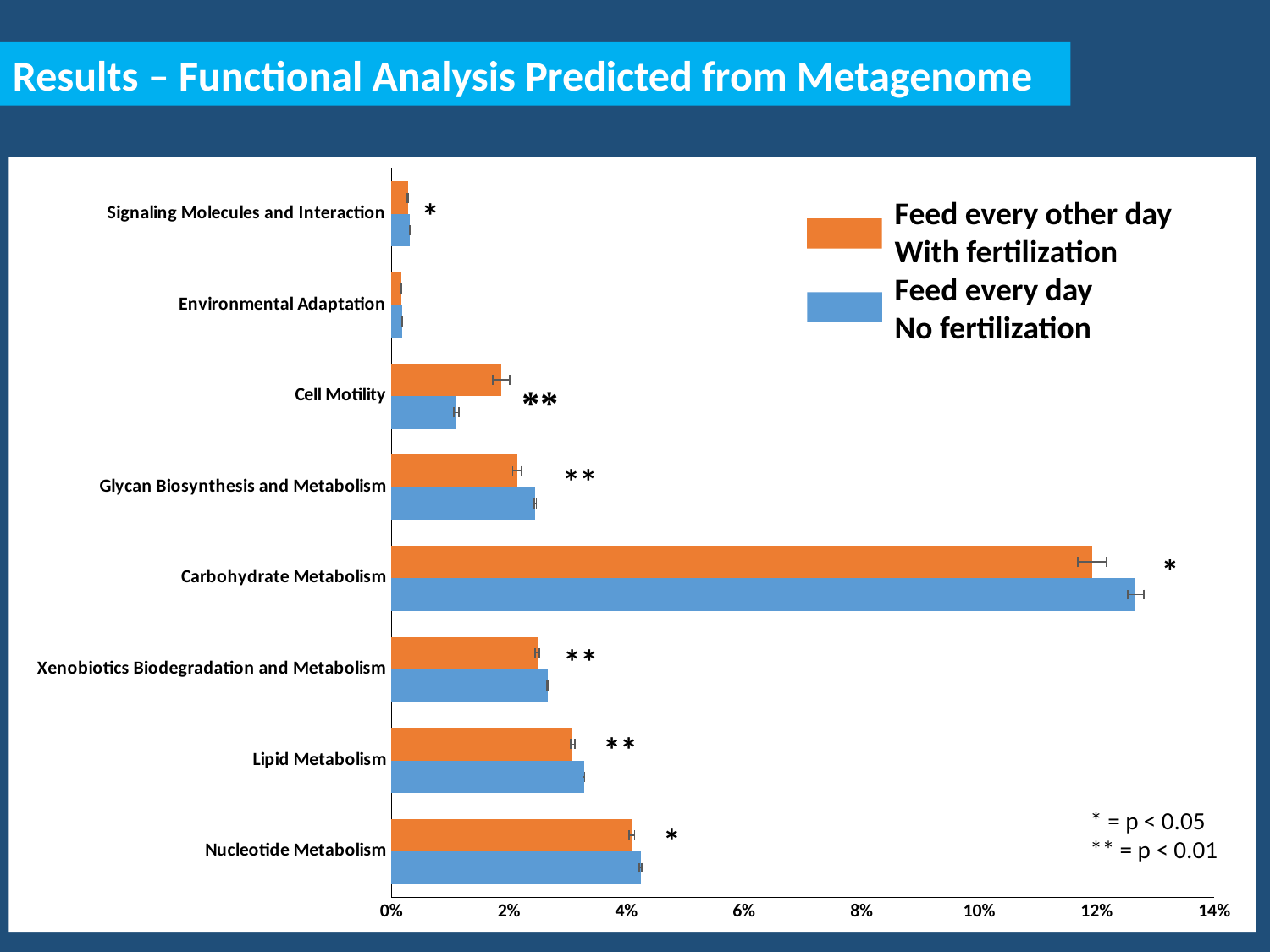
Is the Feed every day / No fertilization value for Carbohydrate Metabolism greater or less than 12%? greater Which category has the lowest value for the Feed every other day / With fertilization series? Environmental Adaptation Which colour represents the Feed every day / No fertilization series? blue How many functional categories are plotted on the chart? 8 Which category has the highest value for the Feed every day / No fertilization series? Carbohydrate Metabolism For Cell Motility, which series has the larger value: Feed every other day / With fertilization or Feed every day / No fertilization? Feed every other day / With fertilization Is the Feed every day / No fertilization value for Lipid Metabolism greater or less than 4%? less Which category has the highest value for the Feed every other day / With fertilization series? Carbohydrate Metabolism What kind of chart is shown on the slide? bar chart For Carbohydrate Metabolism, which series has the larger value: Feed every other day / With fertilization or Feed every day / No fertilization? Feed every day / No fertilization Is the Feed every other day / With fertilization value for Cell Motility greater or less than 2%? less How many series does the legend list? 2